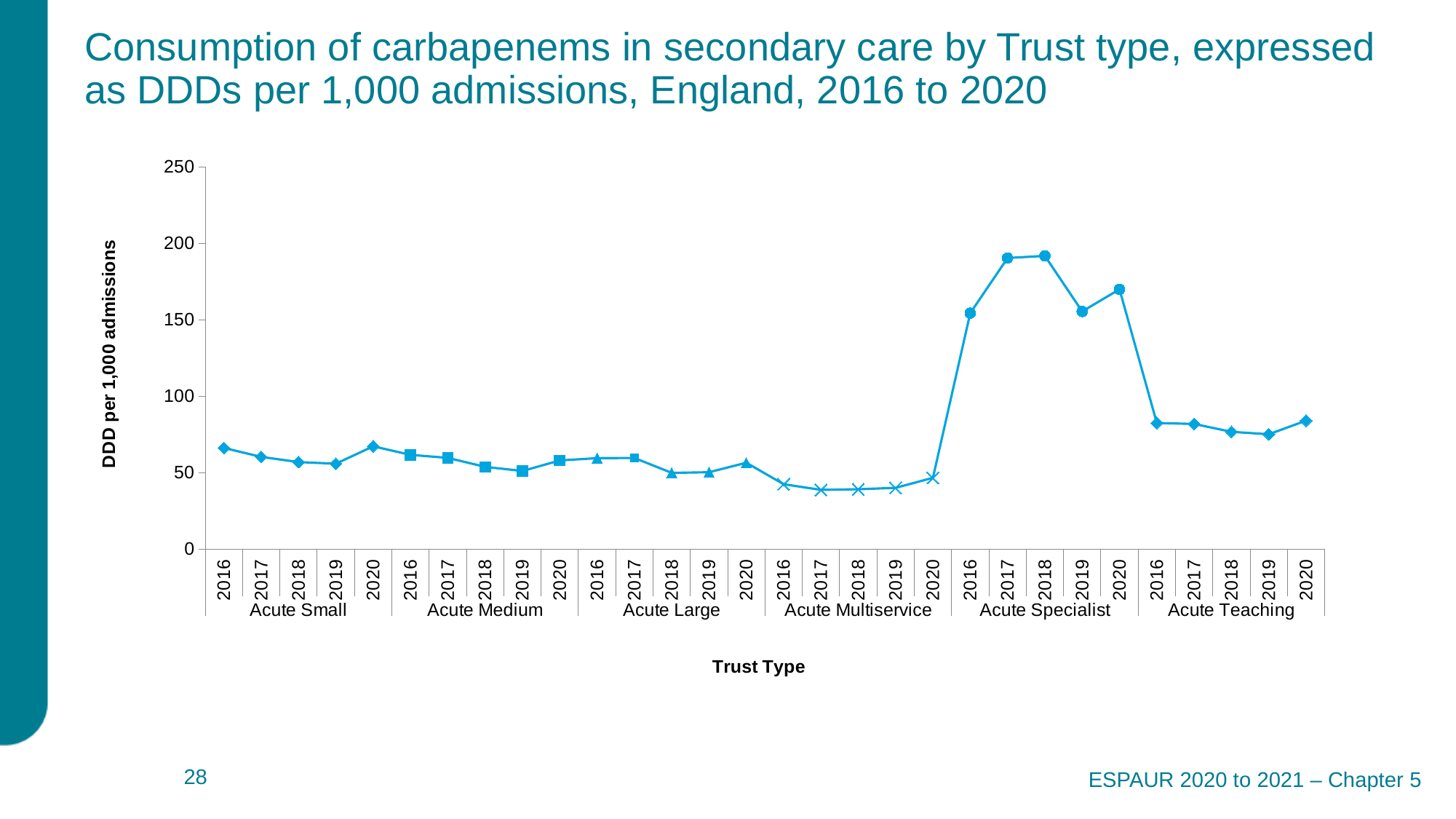
Is the value for Acute Specialist in 2017 greater or less than 150? greater Is the value for Acute Teaching in 2016 greater or less than 100? less How many Trust types are shown on the x axis? 6 For Acute Specialist, does the value rise or fall from 2018 to 2019? Fall What kind of chart is shown on the slide? Line chart Is the value for Acute Multiservice in 2017 greater or less than 50? less Which Trust type has the lowest carbapenem consumption values in the chart? Acute Multiservice Which is larger: the value for Acute Specialist in 2016 or the value for Acute Teaching in 2016? Acute Specialist in 2016 What is the title of the y axis? DDD per 1,000 admissions Which Trust type has the highest carbapenem consumption values in the chart? Acute Specialist How many data points are plotted in total on the chart? 30